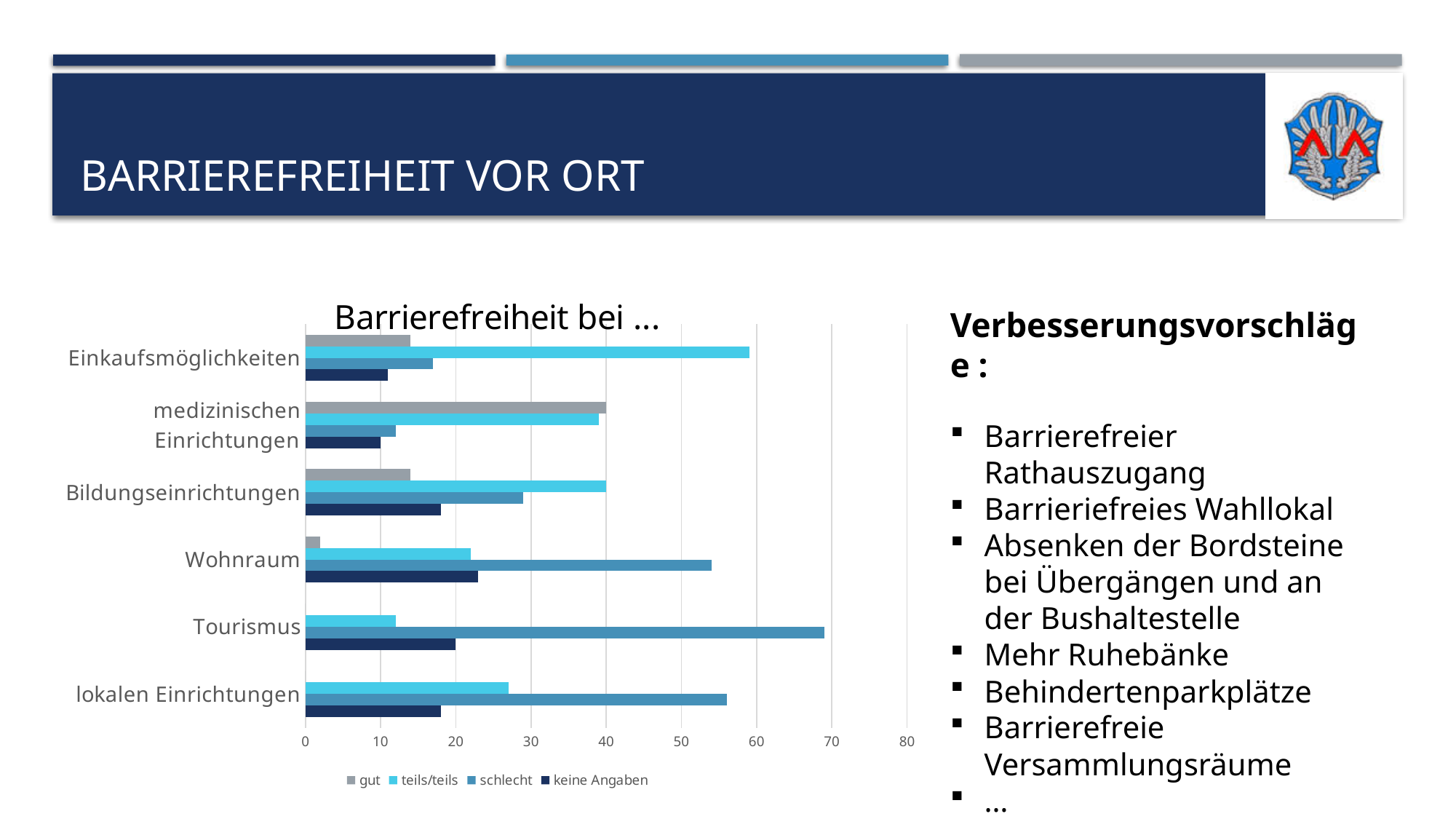
How many series does the chart legend list? 4 Which category has the highest 'schlecht' value? Tourismus For Wohnraum, which is larger: the 'schlecht' value or the 'teils/teils' value? schlecht Is the 'gut' value for Wohnraum greater or less than 10? less What kind of chart is shown on the slide? bar chart Is the 'schlecht' value for Tourismus greater or less than 60? greater Is the 'schlecht' value for medizinischen Einrichtungen greater or less than 20? less How many categories are shown on the chart's vertical axis? 6 Which category has the highest 'gut' value? medizinischen Einrichtungen What is the title of the chart? Barrierefreiheit bei ... Which series are listed in the chart legend? gut, teils/teils, schlecht, keine Angaben